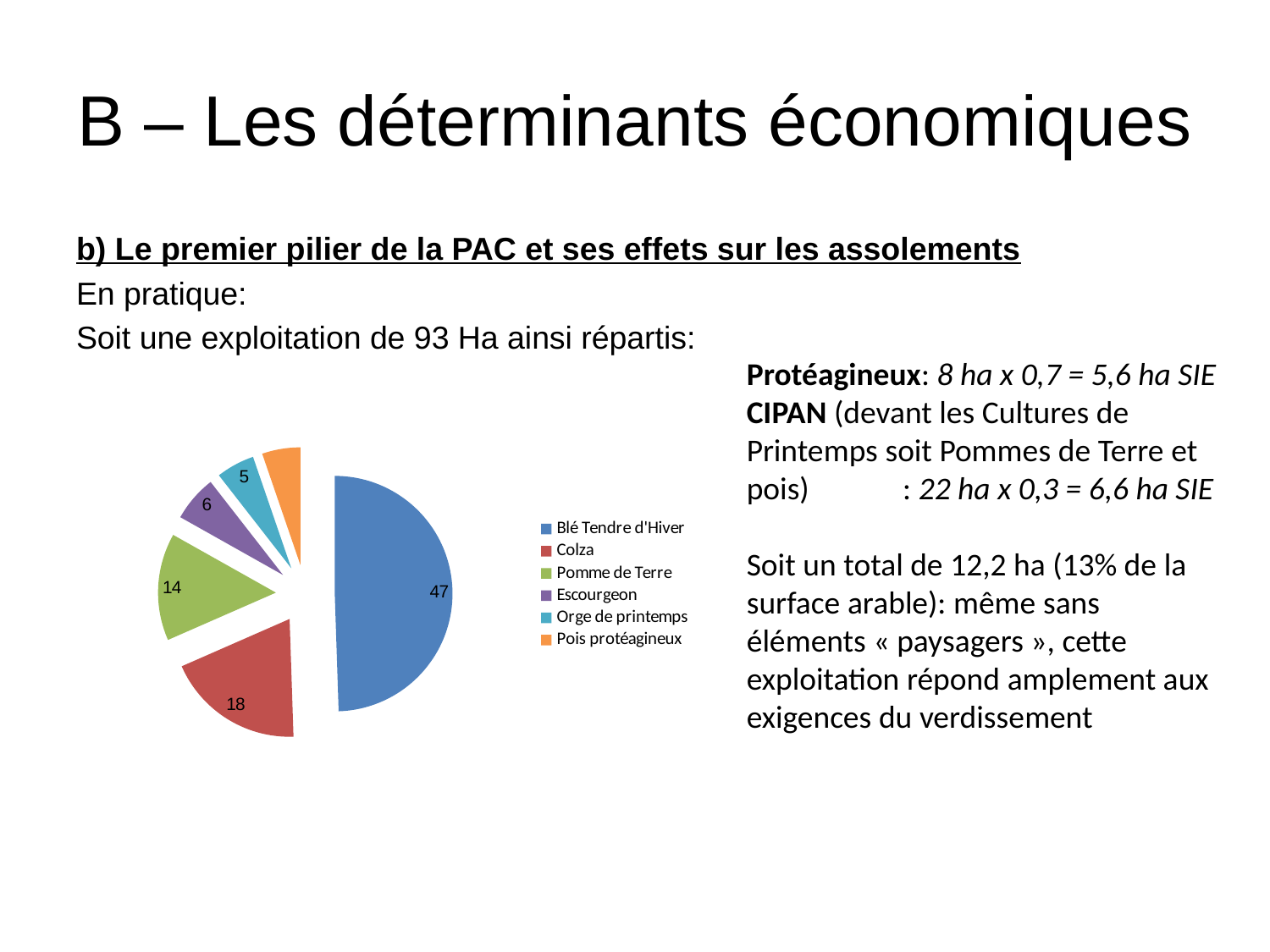
What kind of chart is shown on the slide? Pie chart What value is shown for Pomme de Terre in the pie chart? 14 What is the difference between the values for Colza and Pomme de Terre? 4 What value is shown for Blé Tendre d'Hiver in the pie chart? 47 What value is shown for Colza in the pie chart? 18 Which category has the largest slice in the pie chart? Blé Tendre d'Hiver What value is shown for Orge de printemps in the pie chart? 5 What value is shown for Escourgeon in the pie chart? 6 Which is larger, the value for Escourgeon or the value for Orge de printemps? Escourgeon What colour is the Colza slice in the pie chart? Red How many categories does the pie chart legend list? 6 What is the difference between the values for Blé Tendre d'Hiver and Colza? 29